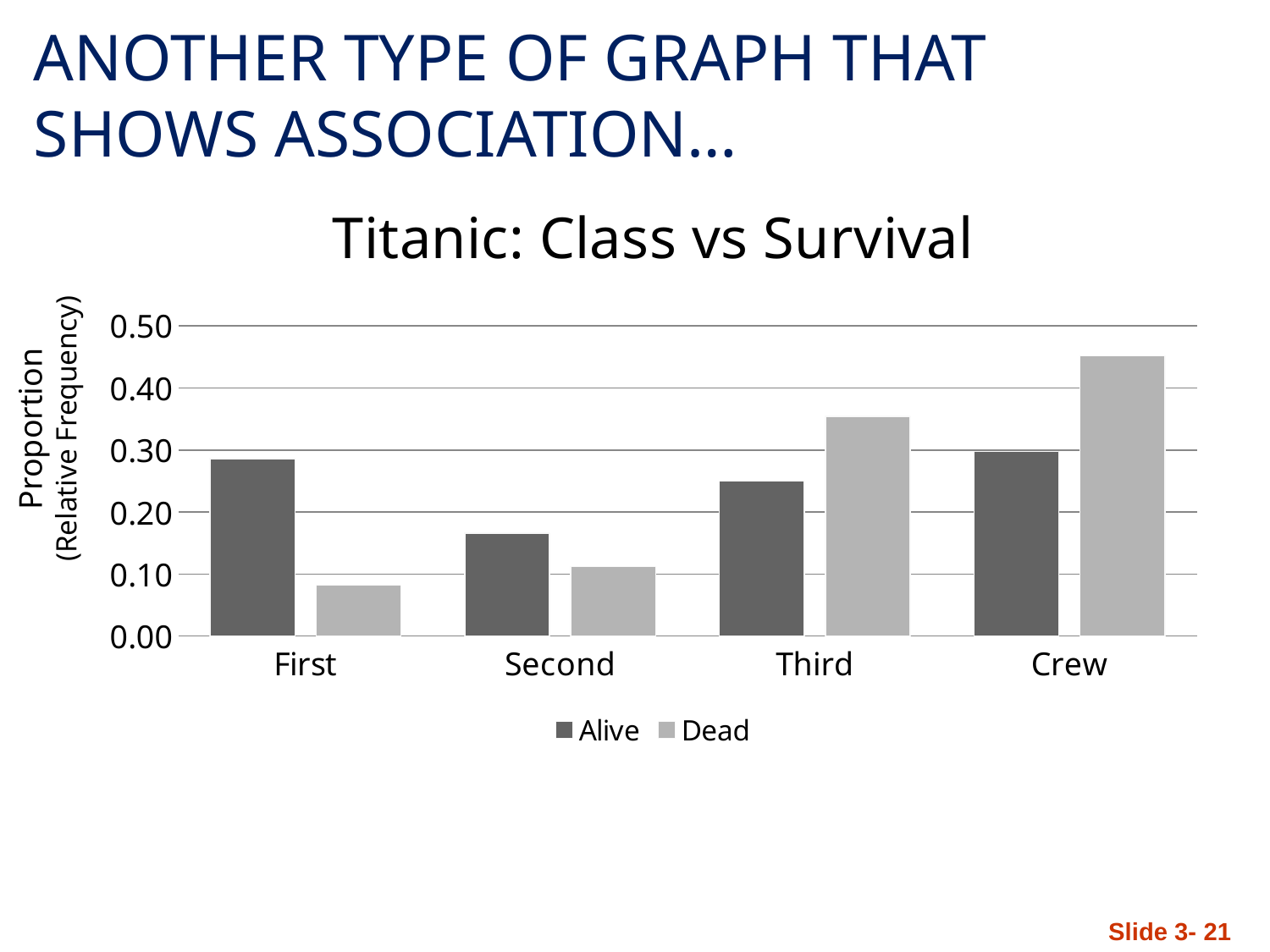
Which class has the lowest Alive proportion? Second What type of chart is shown on the slide? Bar chart What is the label on the vertical axis? Proportion (Relative Frequency) For the First class, which is larger: the Alive or the Dead proportion? Alive How many series does the legend list? 2 Which class has the lowest Dead proportion? First Is the Dead proportion for Crew greater or less than 0.40? greater How many class categories are shown on the x axis? 4 Which class has the highest Dead proportion? Crew What is the title of the chart? Titanic: Class vs Survival Is the Dead proportion for First class greater or less than 0.10? less For the Crew, which is larger: the Alive or the Dead proportion? Dead